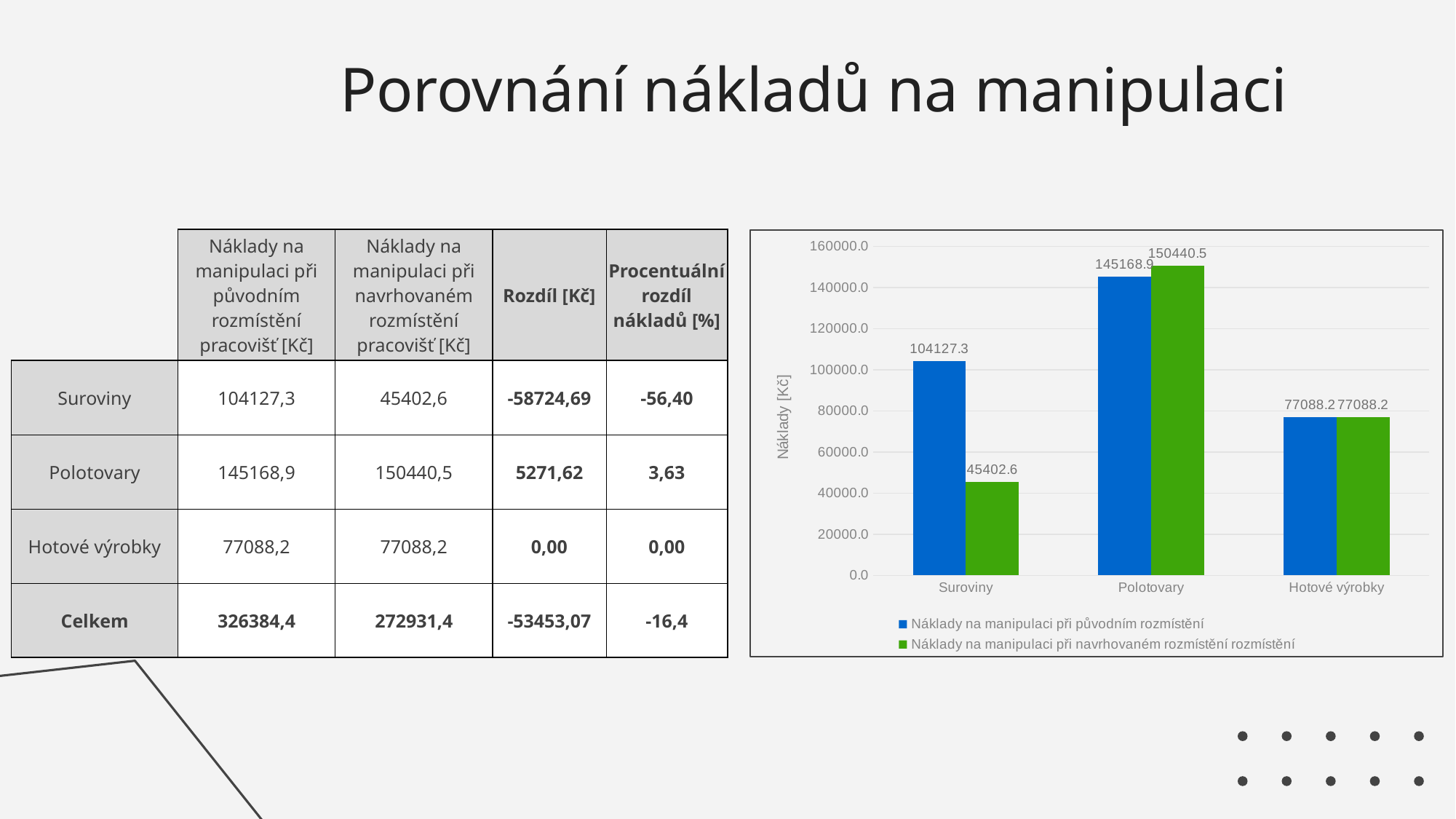
For Polotovary, which series has the larger value? Náklady na manipulaci při navrhovaném rozmístění rozmístění How many categories are shown on the x axis of the chart? 3 How many series does the chart legend list? 2 What is the value for Suroviny in the series 'Náklady na manipulaci při navrhovaném rozmístění rozmístění'? 45402.6 Which category has the lowest value in the series 'Náklady na manipulaci při navrhovaném rozmístění rozmístění'? Suroviny What is the value for Hotové výrobky in the series 'Náklady na manipulaci při původním rozmístění'? 77088.2 What type of chart is shown on the slide? bar chart What is the value for Polotovary in the series 'Náklady na manipulaci při navrhovaném rozmístění rozmístění'? 150440.5 What is the difference between the two series' values for Suroviny? 58724.7 What is the value for Suroviny in the series 'Náklady na manipulaci při původním rozmístění'? 104127.3 What is the label of the vertical axis of the chart? Náklady [Kč] Which category has the highest value in the series 'Náklady na manipulaci při původním rozmístění'? Polotovary